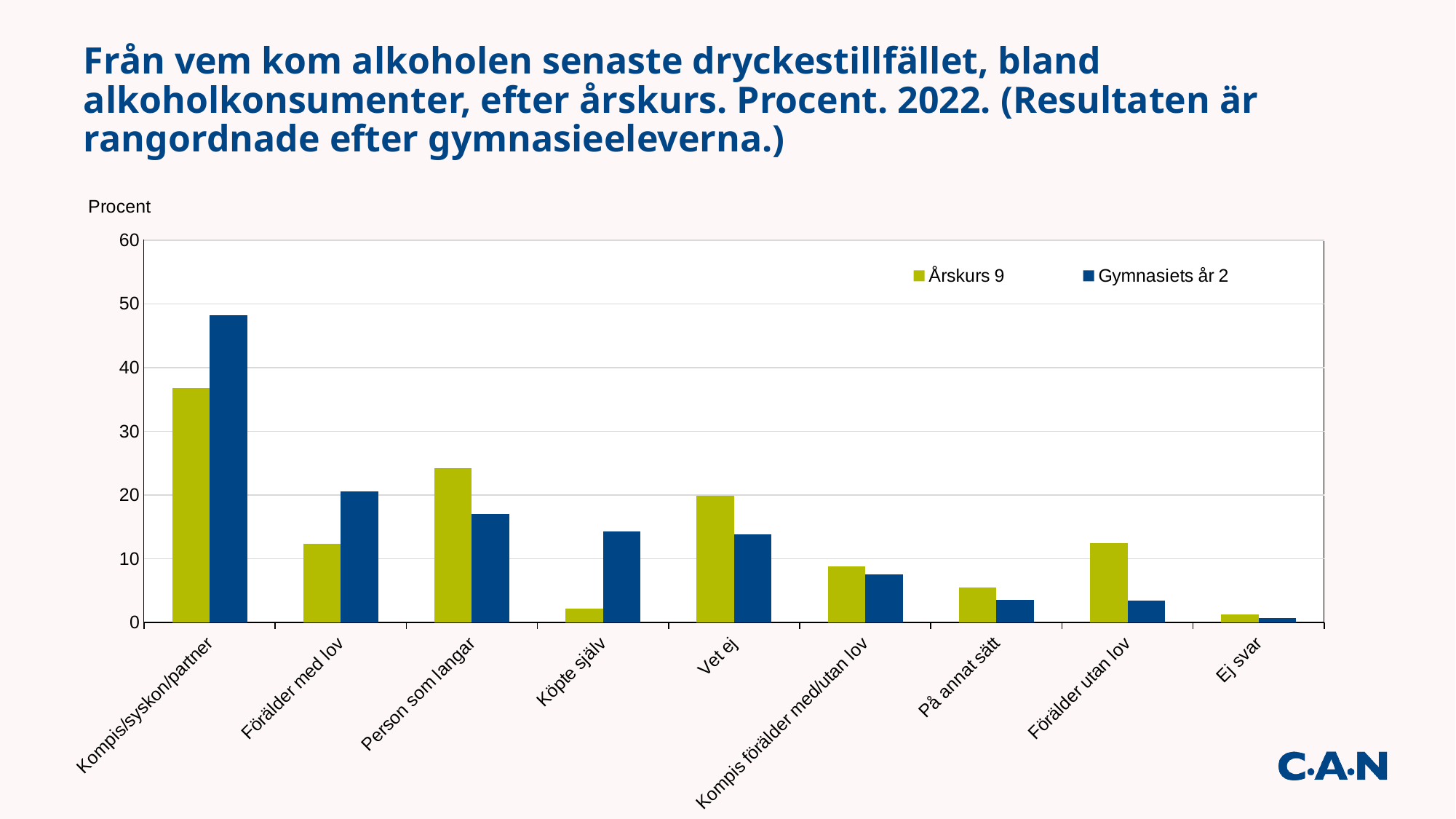
Which category has the lowest value for Årskurs 9? Ej svar How many categories are shown on the x axis? 9 For Person som langar, which series has the larger value, Årskurs 9 or Gymnasiets år 2? Årskurs 9 What label is shown on the y axis of the chart? Procent What kind of chart is shown on the slide? bar chart Is the Årskurs 9 value for Person som langar greater or less than 20? greater Which category has the highest value for Årskurs 9? Kompis/syskon/partner Which category has the highest value for Gymnasiets år 2? Kompis/syskon/partner Is the Gymnasiets år 2 value for Förälder utan lov greater or less than 10? less How many series does the legend list? 2 For Köpte själv, which series has the larger value, Årskurs 9 or Gymnasiets år 2? Gymnasiets år 2 Is the Gymnasiets år 2 value for Kompis/syskon/partner greater or less than 40? greater